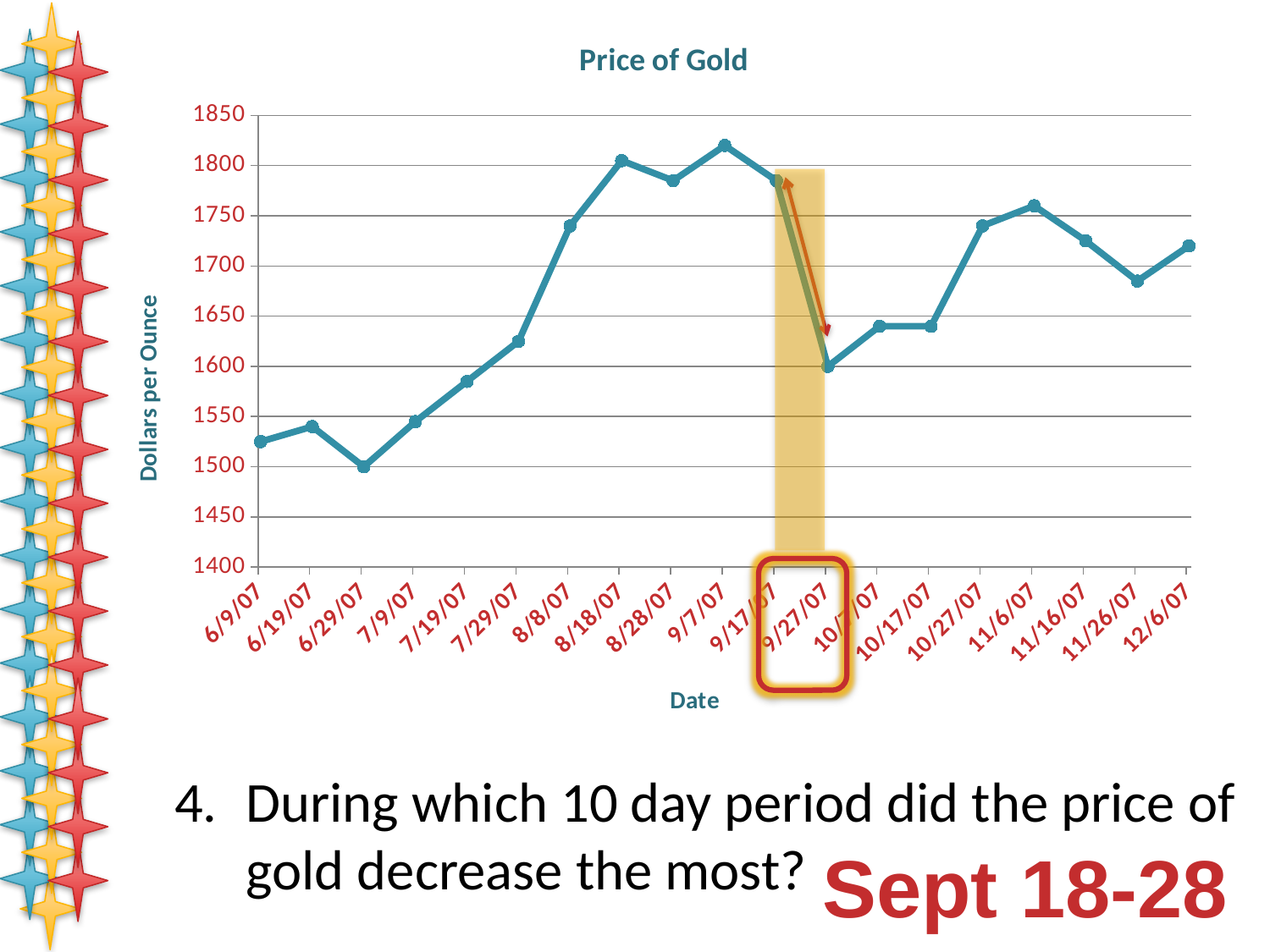
What is the price of gold on 9/27/07? 1600 Is the price of gold on 9/7/07 greater or less than 1800? greater What kind of chart is shown on the slide? line chart How many data points are plotted on the line? 19 On which date does the price of gold reach its highest value? 9/7/07 What is the price of gold on 6/29/07? 1500 Which date has a higher price of gold, 8/18/07 or 11/6/07? 8/18/07 Is the price of gold on 10/7/07 greater or less than 1700? less What is the label on the vertical axis of the chart? Dollars per Ounce What is the title of the chart? Price of Gold On which date is the price of gold at its lowest value? 6/29/07 Does the price of gold rise or fall between 6/29/07 and 8/18/07? rise